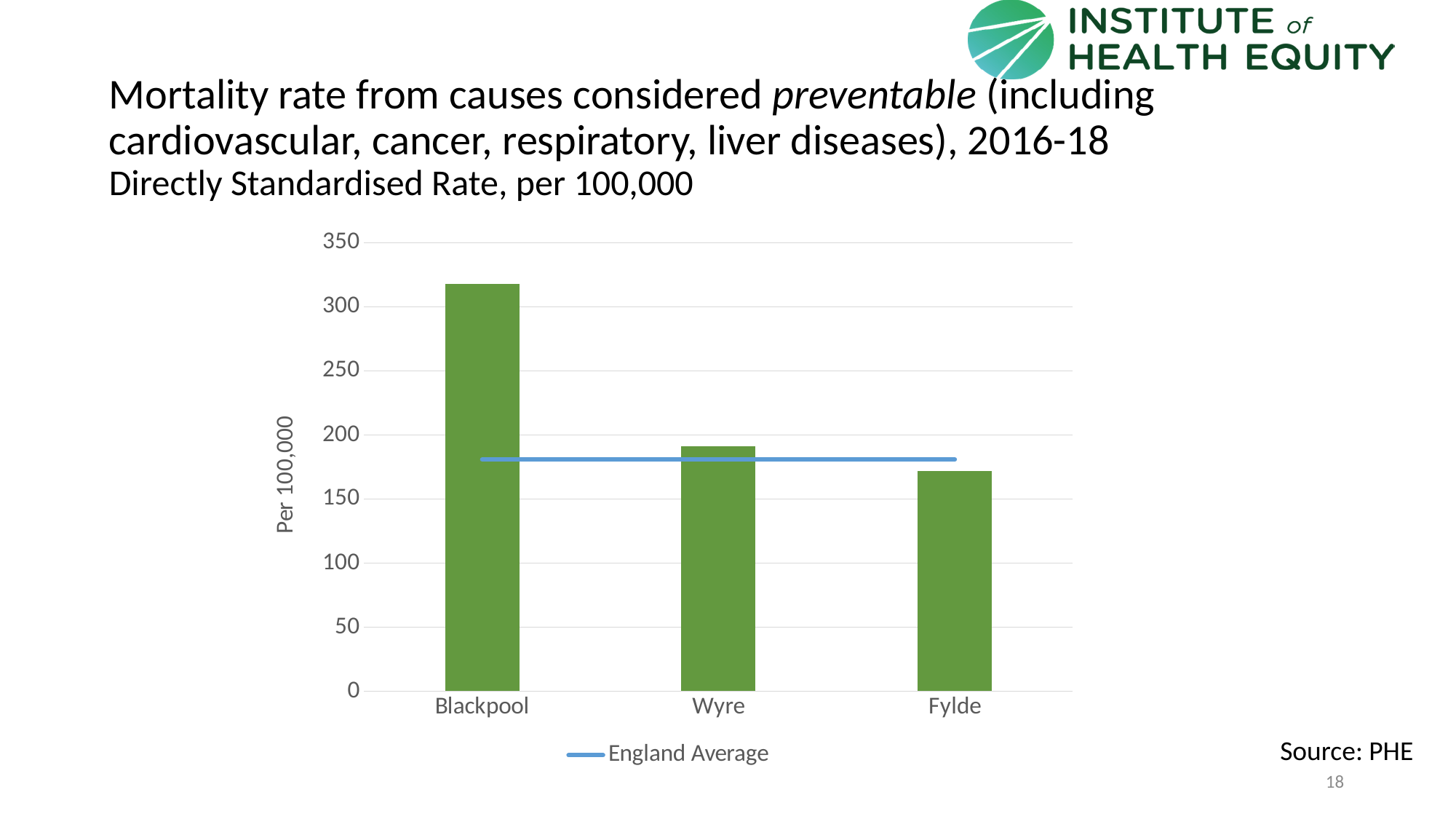
How many entries does the chart legend list? 1 Is the value for Fylde greater or less than 150? greater Do the bar values rise or fall moving from Blackpool to Fylde along the x axis? fall Is the value for Wyre greater or less than 200? less Which has the higher preventable mortality rate, Wyre or Fylde? Wyre Which has the higher preventable mortality rate, Blackpool or Wyre? Blackpool How many local areas are plotted as bars on the chart? 3 Which area has the highest preventable mortality rate on the chart? Blackpool Is the value for Blackpool greater or less than 300? greater Which area has the lowest preventable mortality rate on the chart? Fylde What kind of chart is shown on the slide? bar chart What is the label on the vertical axis of the chart? Per 100,000